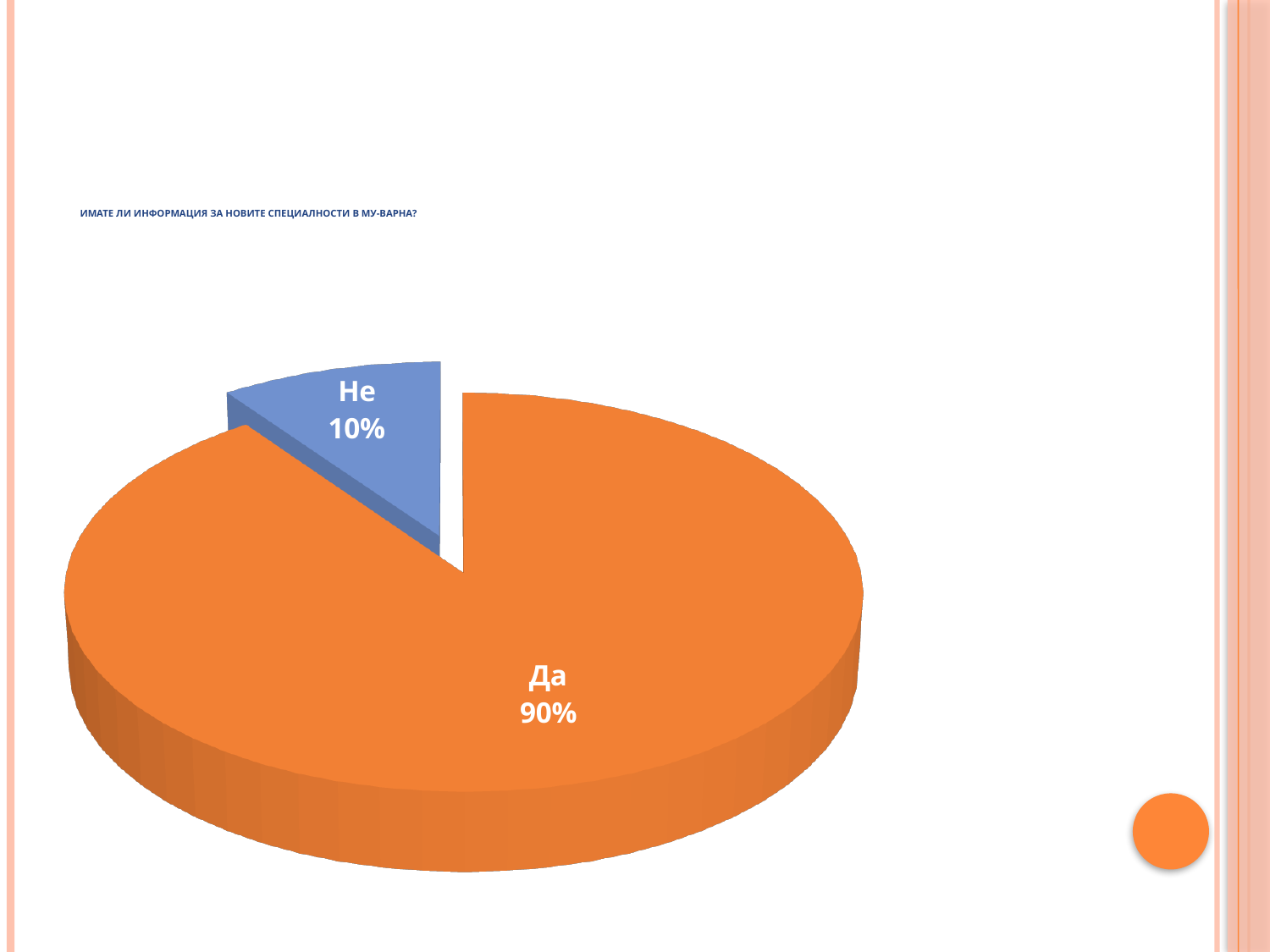
What colour is the "Не" slice? blue What is the title of the chart? ИМАТЕ ЛИ ИНФОРМАЦИЯ ЗА НОВИТЕ СПЕЦИАЛНОСТИ В МУ-ВАРНА? What kind of chart is shown on the slide? pie chart What share of the pie does the "Не" slice represent? 10% What is the difference in percentage points between the "Да" and "Не" slices? 80 Which slice of the pie is the smallest? Не Which slice of the pie is the largest? Да How many slices does the pie chart have? 2 Which is larger, the "Да" slice or the "Не" slice? Да What share of the pie does the "Да" slice represent? 90%